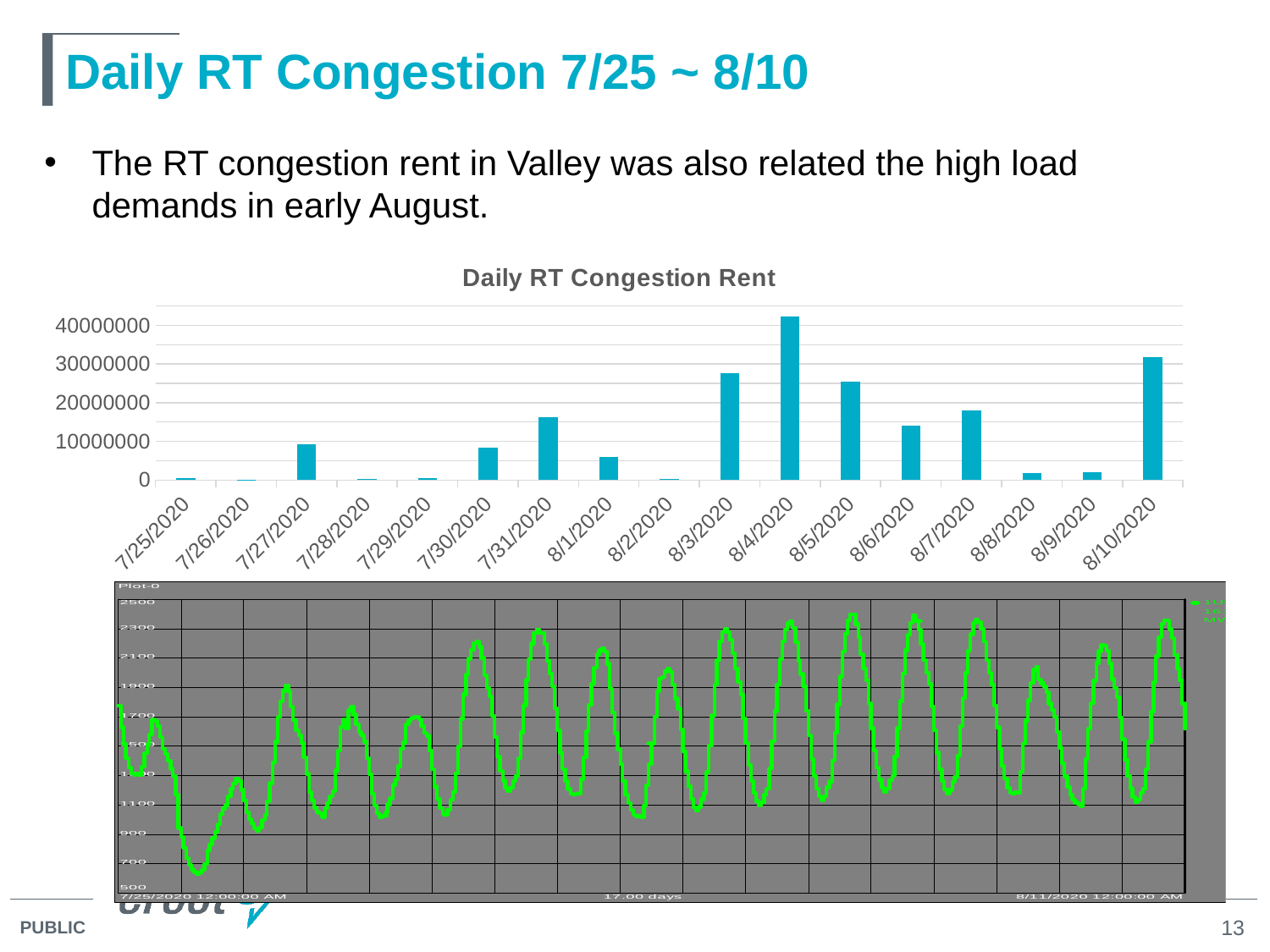
In the 'Daily RT Congestion Rent' chart, is the value for 8/3/2020 greater or less than 30000000? less In the 'Daily RT Congestion Rent' chart, which is larger, the value for 8/4/2020 or the value for 8/10/2020? 8/4/2020 In the 'Daily RT Congestion Rent' chart, is the value for 8/10/2020 greater or less than 20000000? greater In the 'Daily RT Congestion Rent' chart, how many dates are shown on the x axis? 17 In the 'Daily RT Congestion Rent' chart, which date has the highest congestion rent? 8/4/2020 In the 'Daily RT Congestion Rent' chart, is the value for 8/1/2020 greater or less than 10000000? less In the 'Daily RT Congestion Rent' chart, which is larger, the value for 8/3/2020 or the value for 8/6/2020? 8/3/2020 In the 'Plot-0' chart at the bottom of the slide, do the daily peaks of the green line generally rise or fall from late July into early August? Rise In the 'Daily RT Congestion Rent' chart, what is the highest value labelled on the y axis? 40000000 What type of chart is the 'Daily RT Congestion Rent' chart at the top of the slide? Bar chart What type of chart is the green 'Plot-0' chart at the bottom of the slide? Line chart